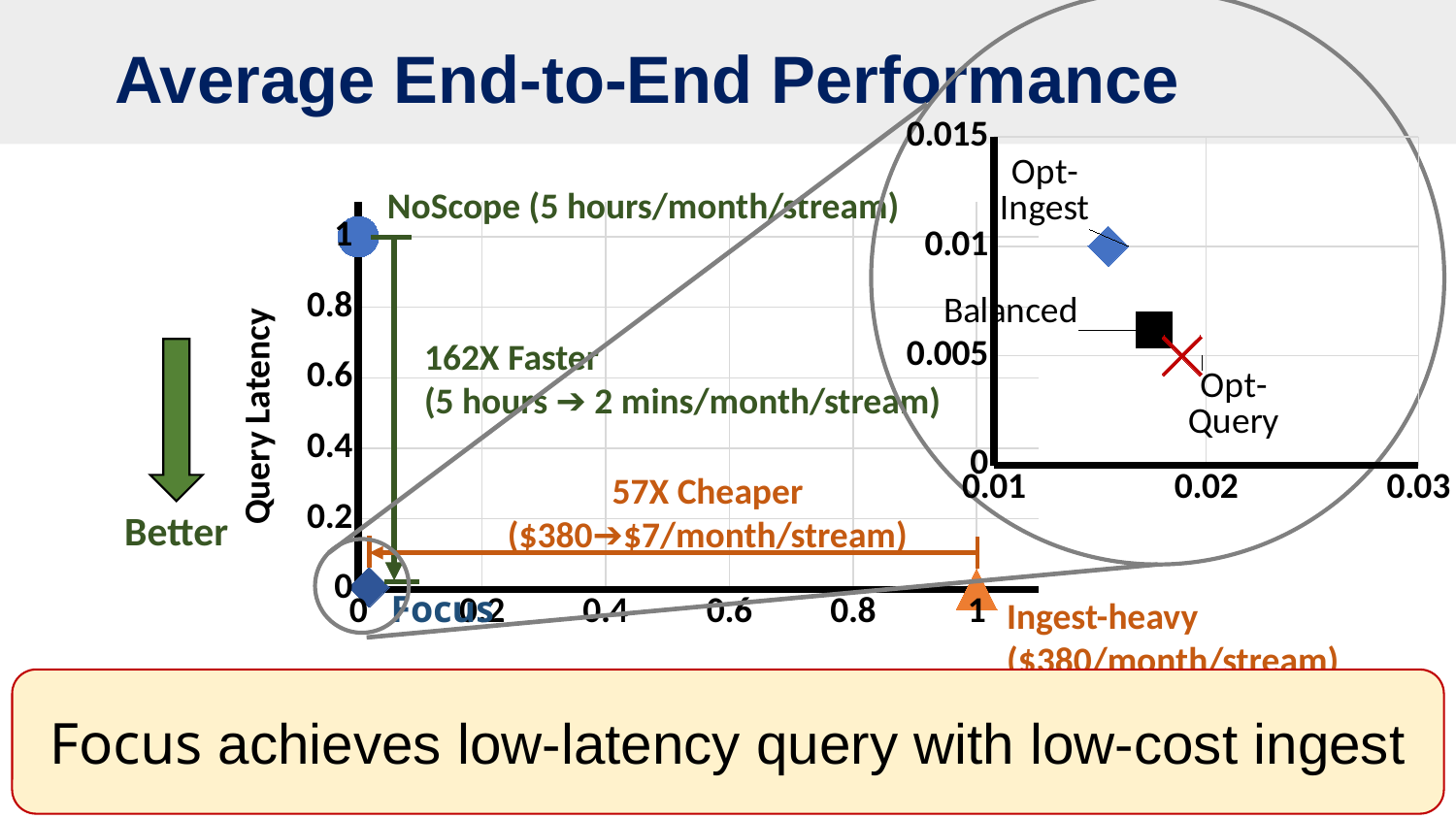
In the zoomed inset chart, which labeled point has the highest y value? Opt-Ingest On the main chart, which point has a higher query latency, NoScope or Focus? NoScope On the main chart, which labeled point has the highest query latency? NoScope What kind of chart is the main chart on the slide? scatter chart On the main chart, what is the x-axis value of the Ingest-heavy point? 1 According to the annotation on the main chart, how many times faster is Focus than NoScope? 162X According to the annotation on the main chart, how many times cheaper is Focus than Ingest-heavy? 57X What is the label of the y axis on the main chart? Query Latency In the zoomed inset chart, is the y value of Opt-Ingest greater or less than 0.005? greater How many labeled points are shown in the zoomed inset chart? 3 On the main chart, what monthly cost per stream is given for Ingest-heavy? $380/month/stream On the main chart, what is the query latency value of the NoScope point? 1